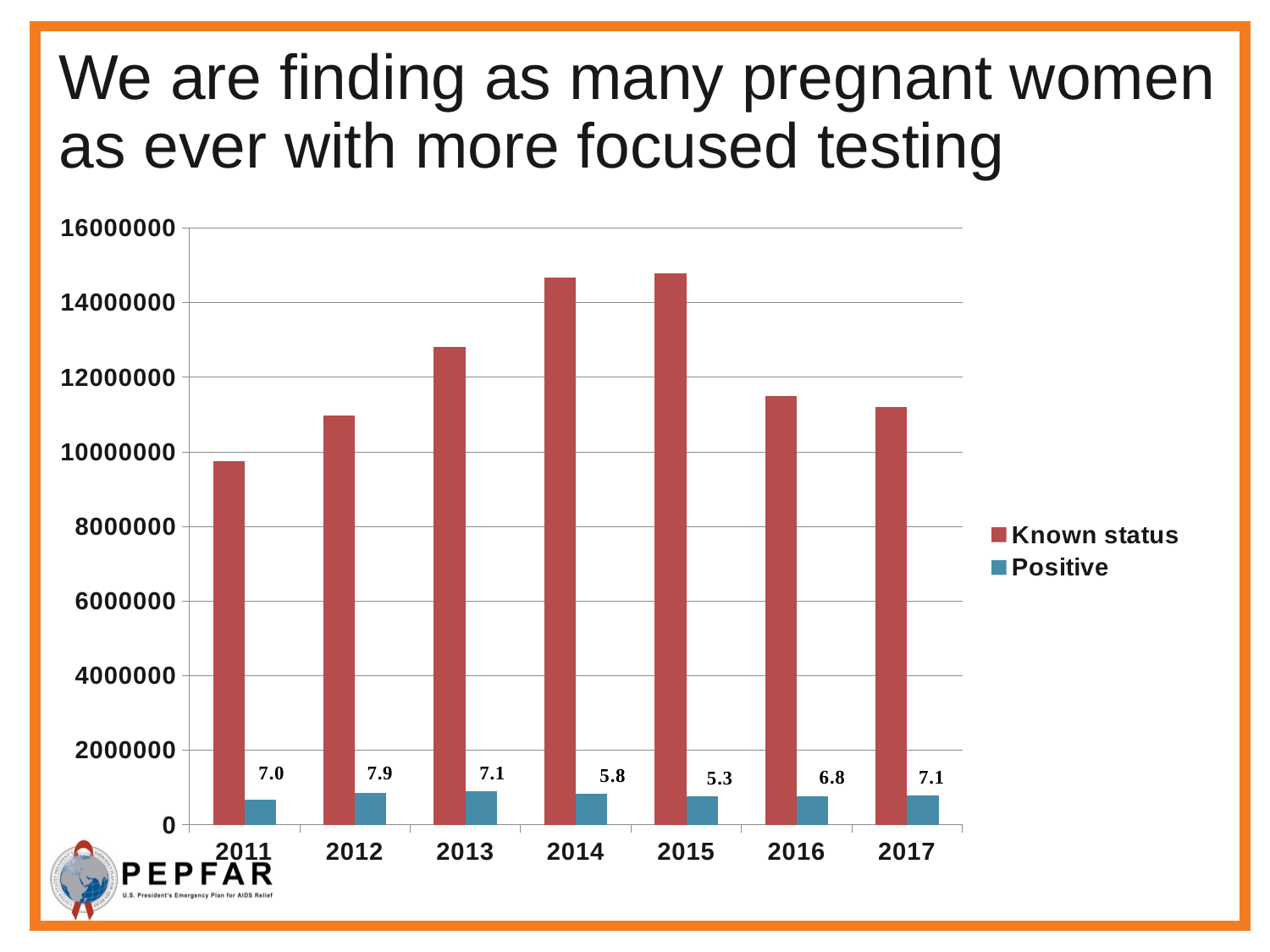
Which year has the larger labelled Positive value, 2014 or 2016? 2016 What is the difference between the labelled Positive values for 2012 and 2015? 2.6 What value is labelled on the Positive bar for 2015? 5.3 What value is labelled on the Positive bar for 2012? 7.9 Which year has the lowest Known status value? 2011 Which year has the highest labelled Positive value? 2012 What kind of chart is shown on the slide? Bar chart How many series does the legend list? 2 How many years are shown on the x axis? 7 Does the Known status value rise or fall from 2011 to 2014? Rise Is the Known status value for 2014 greater or less than 14000000? greater Which year has the lowest labelled Positive value? 2015